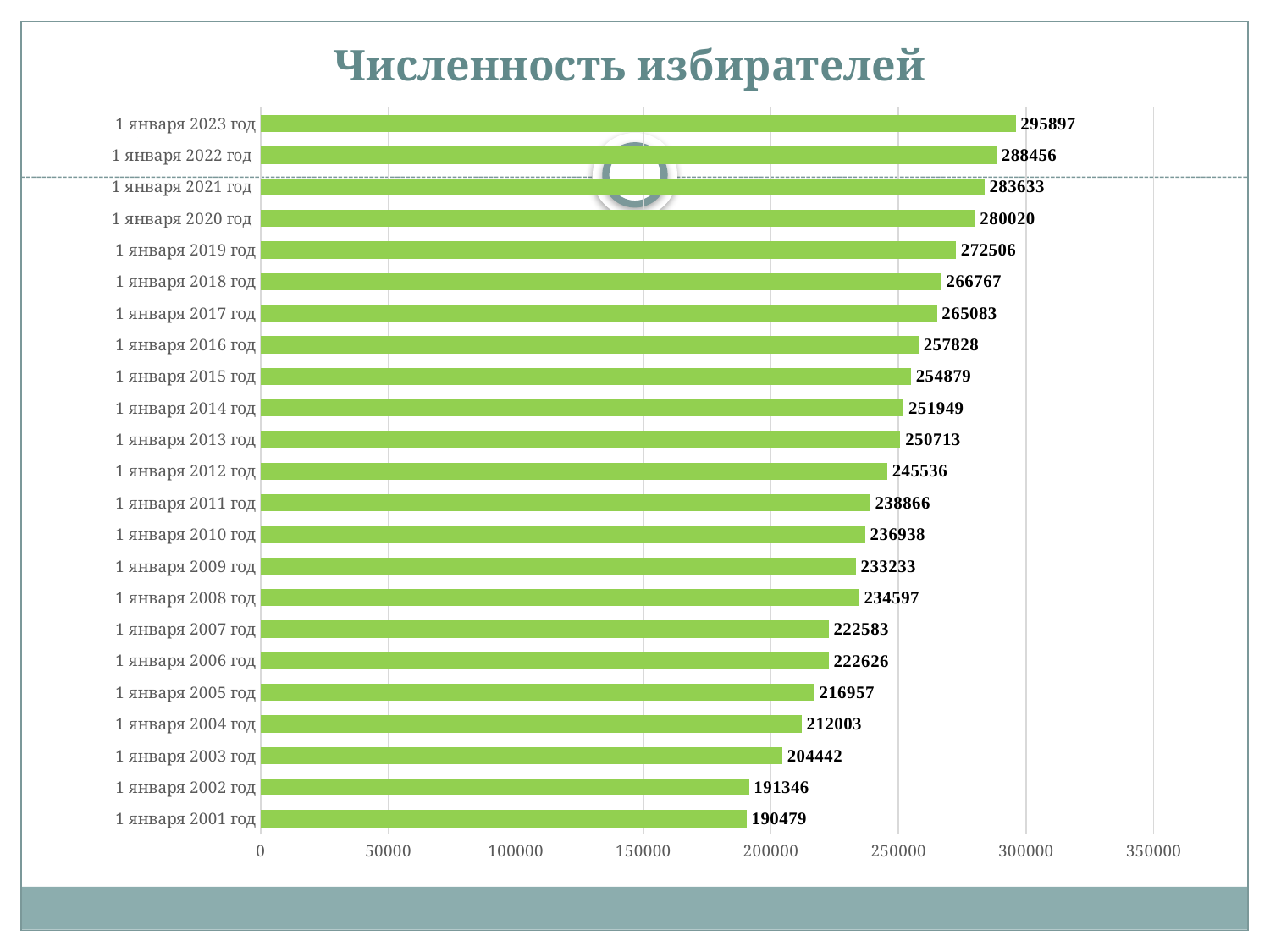
What value is shown for 1 января 2010 год? 236938 What is the number of voters on 1 января 2023 год? 295897 Is the value for 1 января 2015 год greater or less than 250000? greater How many dates (categories) are shown in the chart? 23 Which date has the lowest number of voters? 1 января 2001 год Which is larger, the value for 1 января 2008 год or 1 января 2009 год? 1 января 2008 год Is the value for 1 января 2003 год greater or less than 250000? less What is the difference between the values for 1 января 2023 год and 1 января 2022 год? 7441 Which date has the highest number of voters? 1 января 2023 год What is the number of voters on 1 января 2001 год? 190479 What is the title of the chart? Численность избирателей What kind of chart is shown on the slide? bar chart